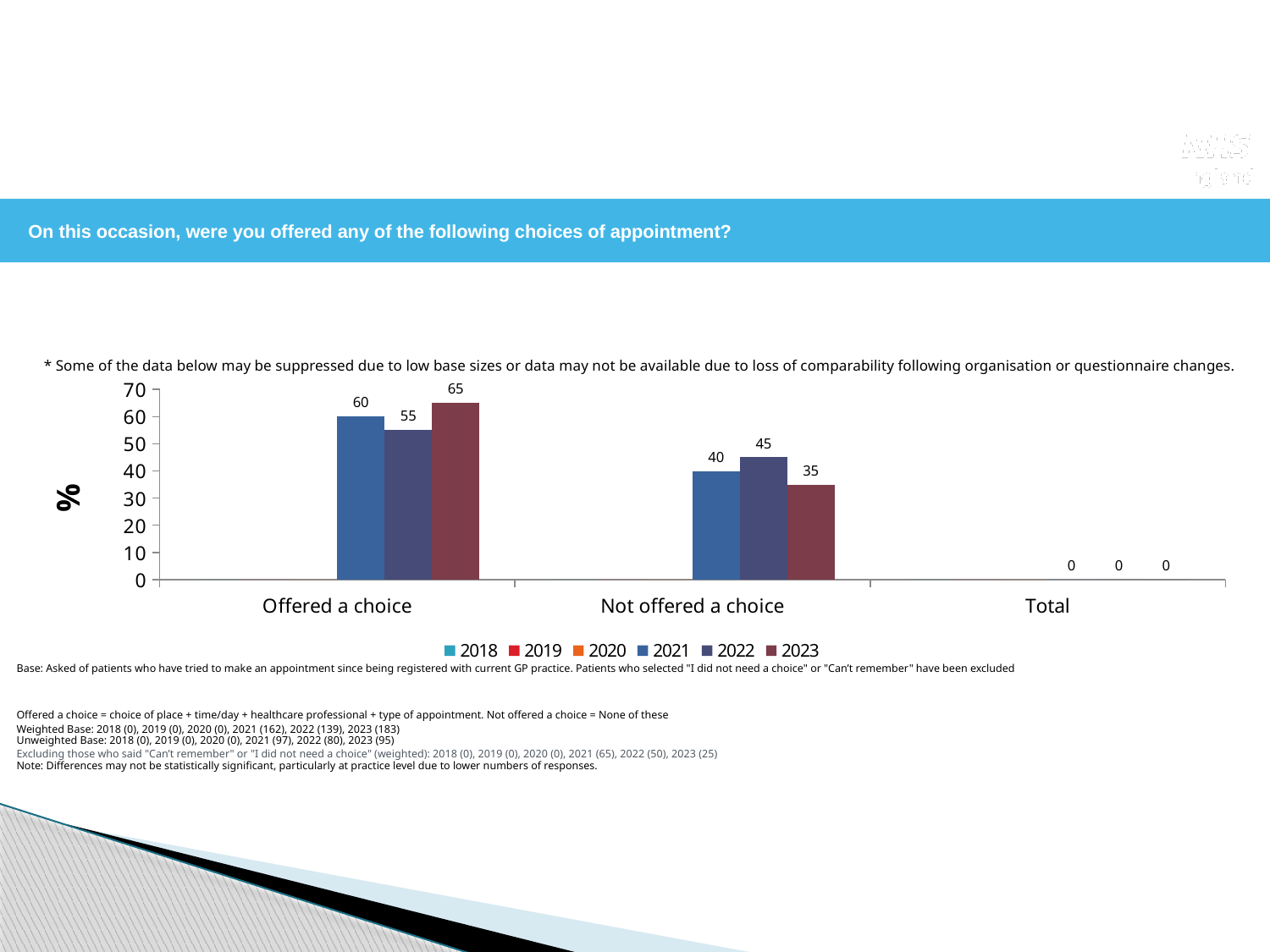
What is the value for 2023 in the 'Offered a choice' category? 65 What kind of chart is shown on the slide? bar chart How many categories are shown on the x axis? 3 What is the value for 2022 in the 'Offered a choice' category? 55 What value is shown for the 'Total' category for 2023? 0 What is the label on the y axis? % How many series does the legend list? 6 Which year has the highest value in the 'Offered a choice' category? 2023 What is the value for 2021 in the 'Not offered a choice' category? 40 Which is larger: the 2021 value or the 2022 value for 'Not offered a choice'? 2022 Which year has the lowest value in the 'Not offered a choice' category? 2023 What is the difference between the 2023 and 2022 values in the 'Offered a choice' category? 10